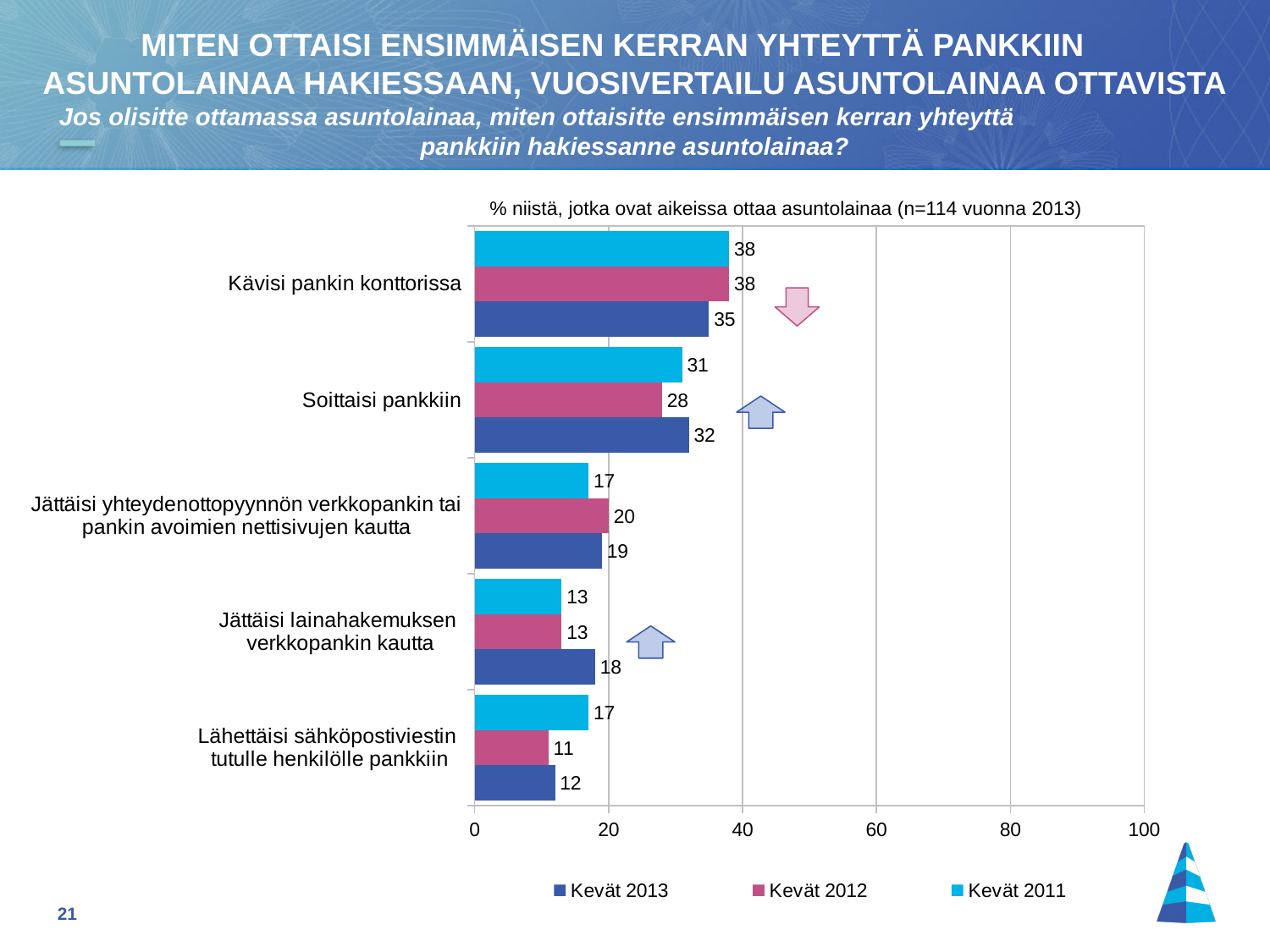
Which category has the highest value in Kevät 2013? Kävisi pankin konttorissa What is the value for Soittaisi pankkiin in Kevät 2012? 28 What is the value for Jättäisi lainahakemuksen verkkopankin kautta in Kevät 2013? 18 Which series is shown in pink in the legend? Kevät 2012 Which category has the lowest value in Kevät 2012? Lähettäisi sähköpostiviestin tutulle henkilölle pankkiin What is the value for Kävisi pankin konttorissa in Kevät 2013? 35 What kind of chart is shown on the slide? bar chart What is the value for Lähettäisi sähköpostiviestin tutulle henkilölle pankkiin in Kevät 2011? 17 How many categories are shown on the chart? 5 Which is larger for Soittaisi pankkiin: the Kevät 2013 value or the Kevät 2012 value? Kevät 2013 How many series does the legend list? 3 What is the difference between the Kevät 2013 and Kevät 2012 values for Jättäisi lainahakemuksen verkkopankin kautta? 5